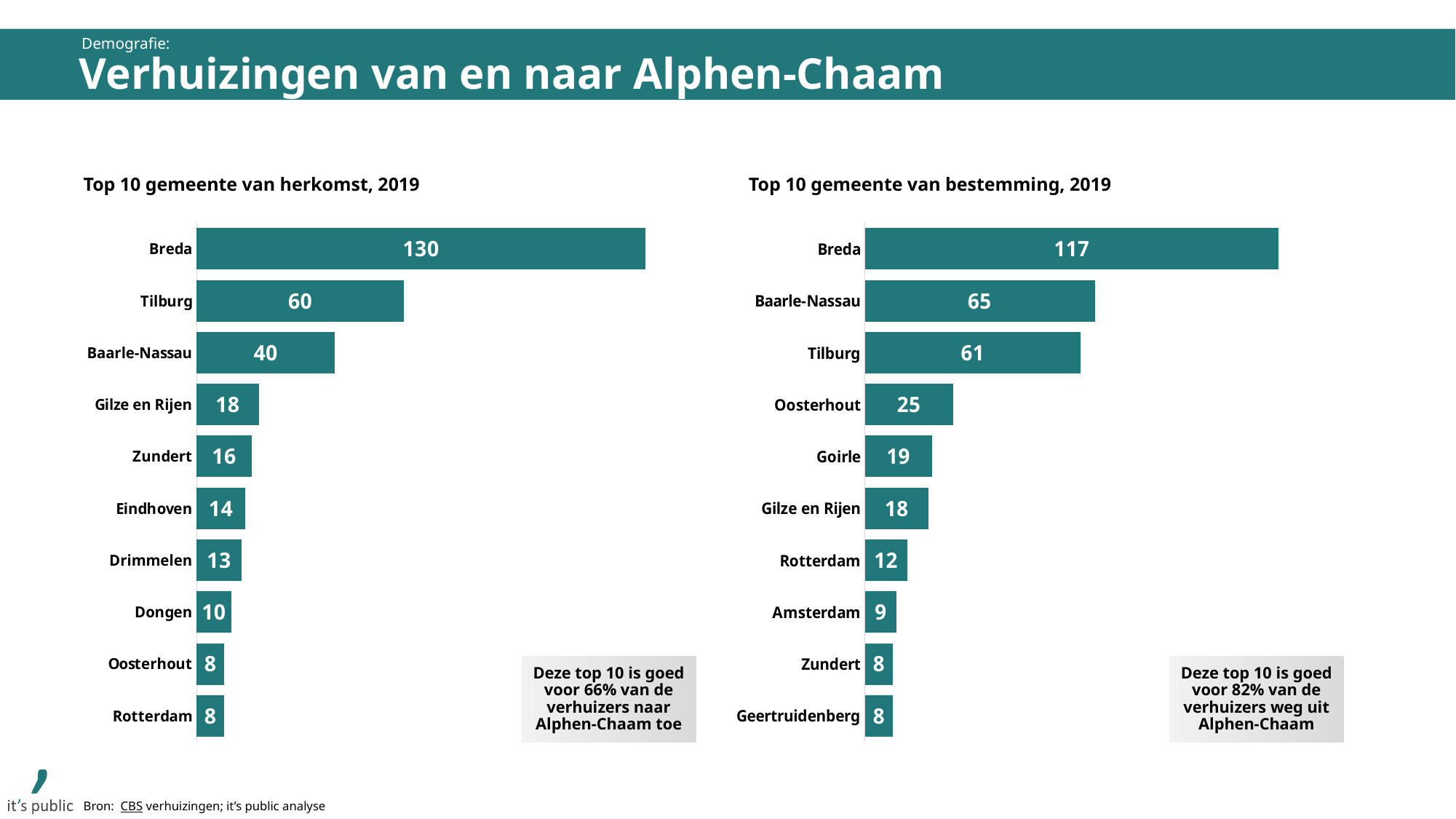
In the chart 'Top 10 gemeente van bestemming, 2019', what is the difference between the values for Baarle-Nassau and Tilburg? 4 In the chart 'Top 10 gemeente van bestemming, 2019', which is larger: the value for Goirle or the value for Rotterdam? Goirle In the chart 'Top 10 gemeente van bestemming, 2019', which gemeente has the lowest value? Zundert and Geertruidenberg According to the text box next to the chart 'Top 10 gemeente van bestemming, 2019', what share of the verhuizers weg uit Alphen-Chaam does this top 10 account for? 82% In the chart 'Top 10 gemeente van herkomst, 2019', what is the value for Tilburg? 60 In the chart 'Top 10 gemeente van herkomst, 2019', what is the value for Gilze en Rijen? 18 What kind of chart is 'Top 10 gemeente van bestemming, 2019'? Bar chart In the chart 'Top 10 gemeente van herkomst, 2019', what is the difference between the values for Breda and Tilburg? 70 How many gemeenten are shown in the chart 'Top 10 gemeente van herkomst, 2019'? 10 Which is larger: the value for Breda in the chart 'Top 10 gemeente van herkomst, 2019' or the value for Breda in the chart 'Top 10 gemeente van bestemming, 2019'? Top 10 gemeente van herkomst, 2019 In the chart 'Top 10 gemeente van bestemming, 2019', what is the value for Oosterhout? 25 In the chart 'Top 10 gemeente van herkomst, 2019', which gemeente has the highest value? Breda